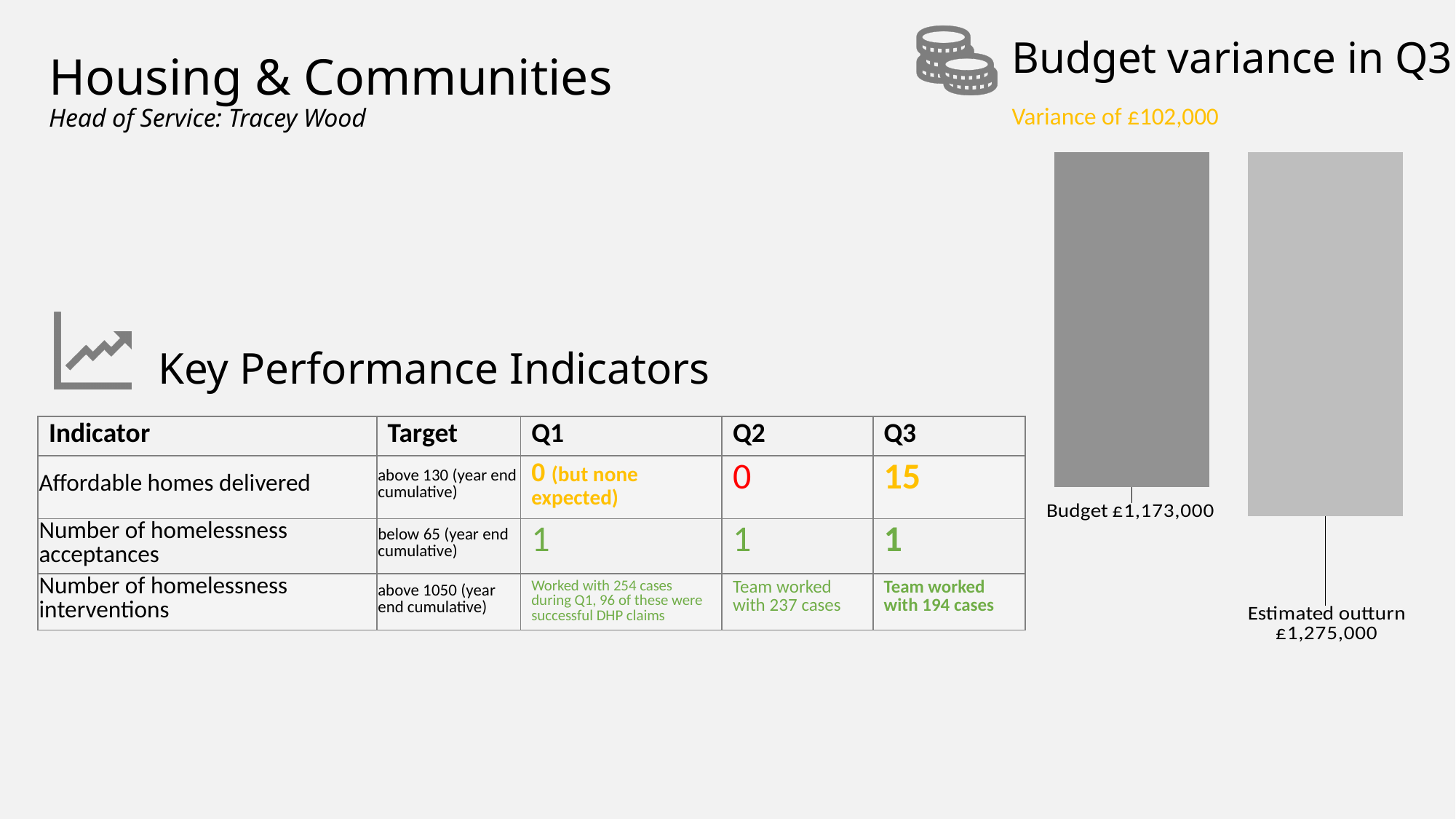
What variance amount is stated above the Budget variance in Q3 chart? Variance of £102,000 Which category has the lowest value in the Budget variance in Q3 chart? Budget What is the difference between the Estimated outturn and the Budget in the Budget variance in Q3 chart? £102,000 What is the value of the Budget bar in the Budget variance in Q3 chart? £1,173,000 In the Budget variance in Q3 chart, which bar is taller, Budget or Estimated outturn? Estimated outturn What type of chart is used to show the budget variance in Q3? Bar chart What is the value of the Estimated outturn bar in the Budget variance in Q3 chart? £1,275,000 How many bars are shown in the Budget variance in Q3 chart? 2 Which category has the highest value in the Budget variance in Q3 chart? Estimated outturn What is the title of the chart on the right side of the slide? Budget variance in Q3